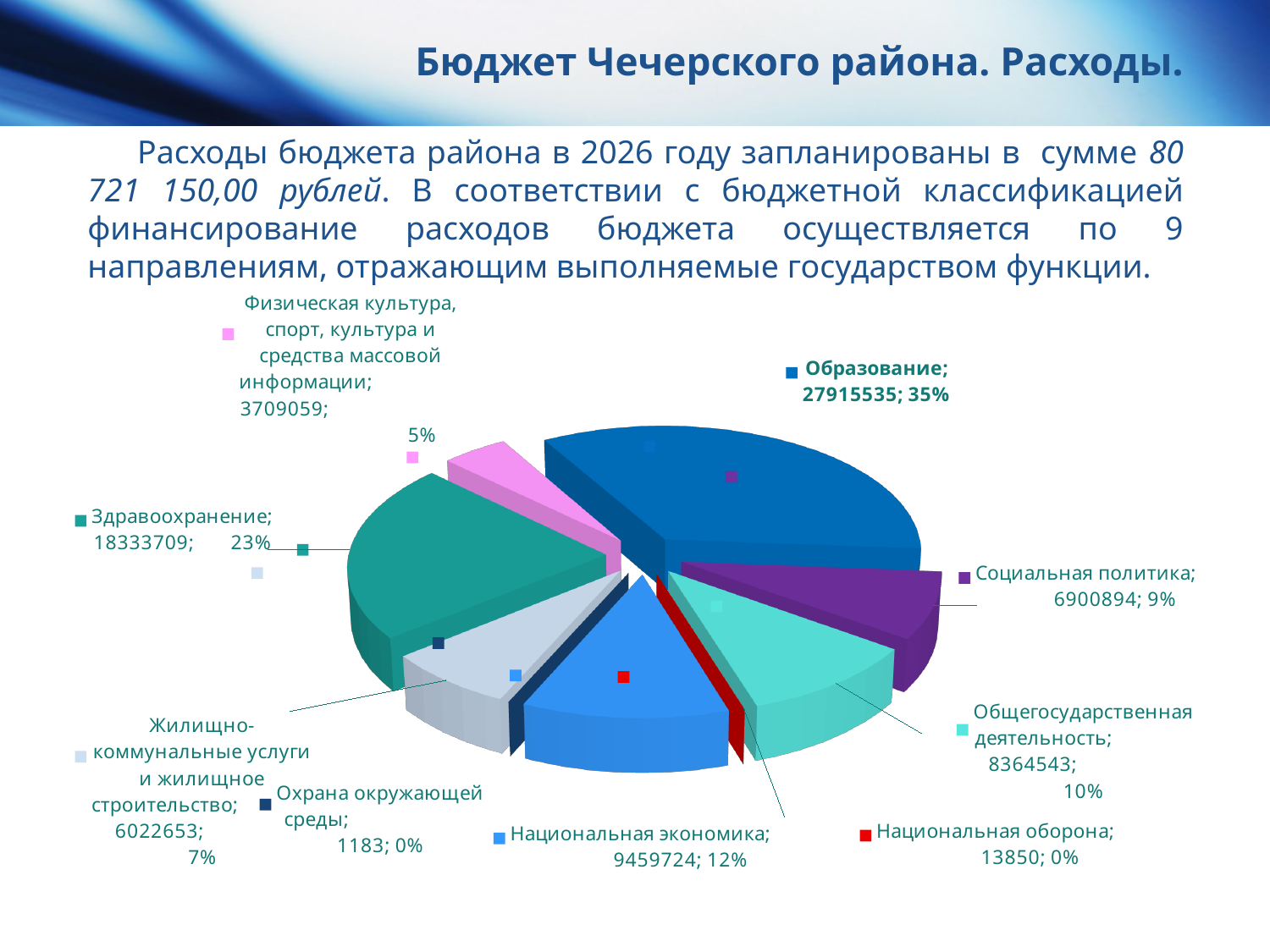
What is the difference between the values for Образование and Здравоохранение? 9581826 What is the value shown for Национальная экономика? 9459724 What is the value shown for Национальная оборона? 13850 Which category has the largest slice of the pie? Образование What is the value shown for Образование? 27915535 Which is larger: the value for Общегосударственная деятельность or the value for Социальная политика? Общегосударственная деятельность What percentage share is shown for Жилищно-коммунальные услуги и жилищное строительство? 7% How many categories (slices) does the pie chart show? 9 What kind of chart is shown on the slide? Pie chart Which category has the smallest value in the pie chart? Охрана окружающей среды What share of the pie does Здравоохранение represent? 23% What is the title of the slide containing the chart? Бюджет Чечерского района. Расходы.